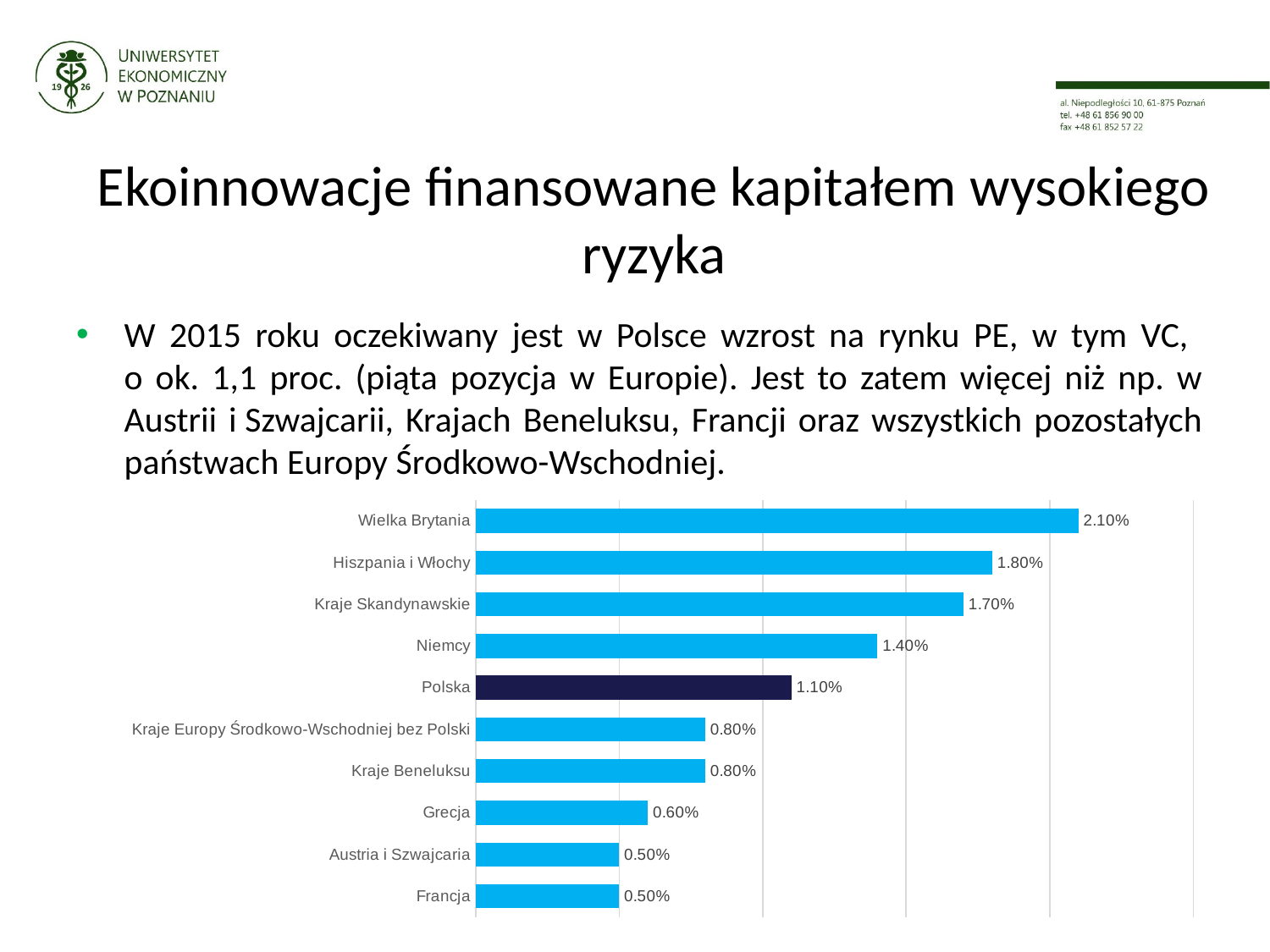
What is the value for Kraje Skandynawskie? 1.70% Which is larger, the value for Kraje Beneluksu or the value for Grecja? Kraje Beneluksu What is the value for Austria i Szwajcaria? 0.50% What is the difference between the values for Wielka Brytania and Hiszpania i Włochy? 0.30% What is the value for Niemcy? 1.40% Which bar is drawn in a different (dark navy) colour from the others? Polska What kind of chart is shown on the slide? Bar chart Which category has the highest value? Wielka Brytania What is the difference between the values for Polska and Grecja? 0.50% Which is larger, the value for Niemcy or the value for Polska? Niemcy How many categories are shown in the chart? 10 What is the value for Polska? 1.10%